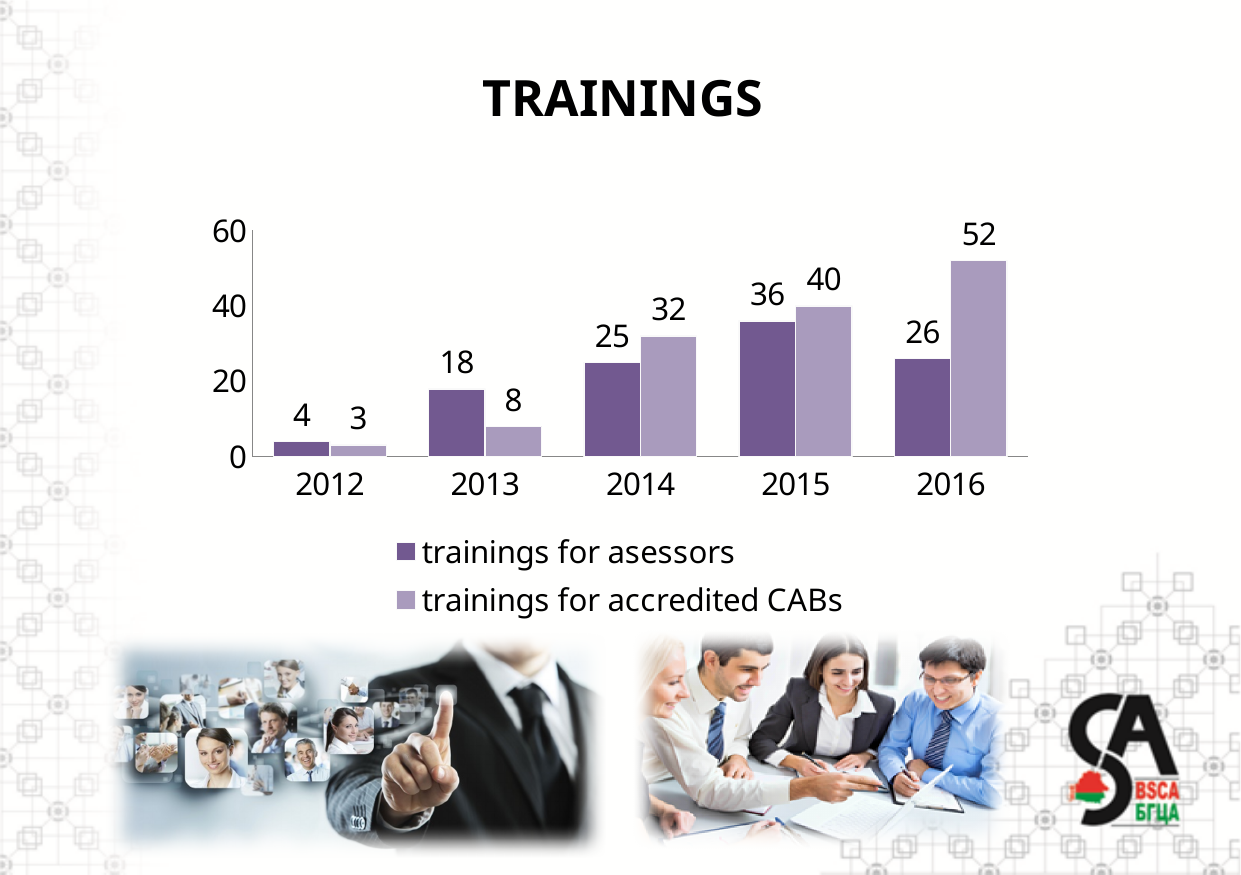
How many series does the legend list? 2 What kind of chart is shown on the slide? bar chart What is the difference between trainings for accredited CABs and trainings for asessors in 2016? 26 What is the value for trainings for accredited CABs in 2013? 8 In 2013, which is larger: trainings for asessors or trainings for accredited CABs? trainings for asessors Is the value for trainings for accredited CABs in 2015 greater or less than 20? greater Which year has the lowest value for trainings for asessors? 2012 How many years are shown on the x axis? 5 What is the value for trainings for asessors in 2015? 36 What is the value for trainings for accredited CABs in 2016? 52 What is the title of the slide? TRAININGS Which year has the highest value for trainings for accredited CABs? 2016